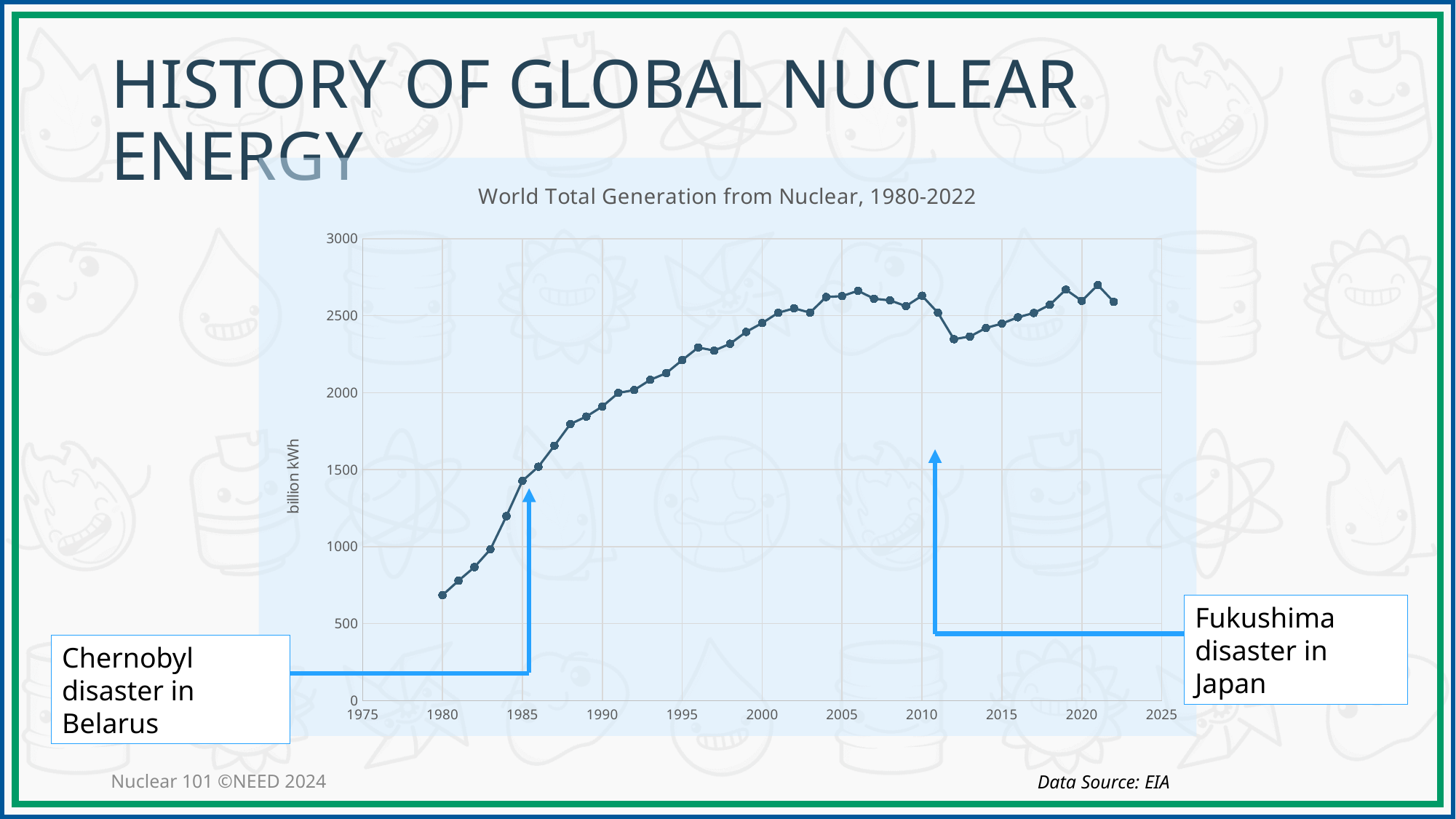
What kind of chart is shown on the slide? line chart Is the value for 1980 greater or less than 1000? less Is the value for 2012 greater or less than 2500? less Is the value for 2022 greater or less than 2500? greater Which year has the larger value, 1990 or 2000? 2000 What is the title of the chart? World Total Generation from Nuclear, 1980-2022 What unit is shown on the vertical axis of the chart? billion kWh Which year has the lowest value on the chart? 1980 Do the values rise or fall from 1980 to 2005? rise Which year has the larger value, 2010 or 2012? 2010